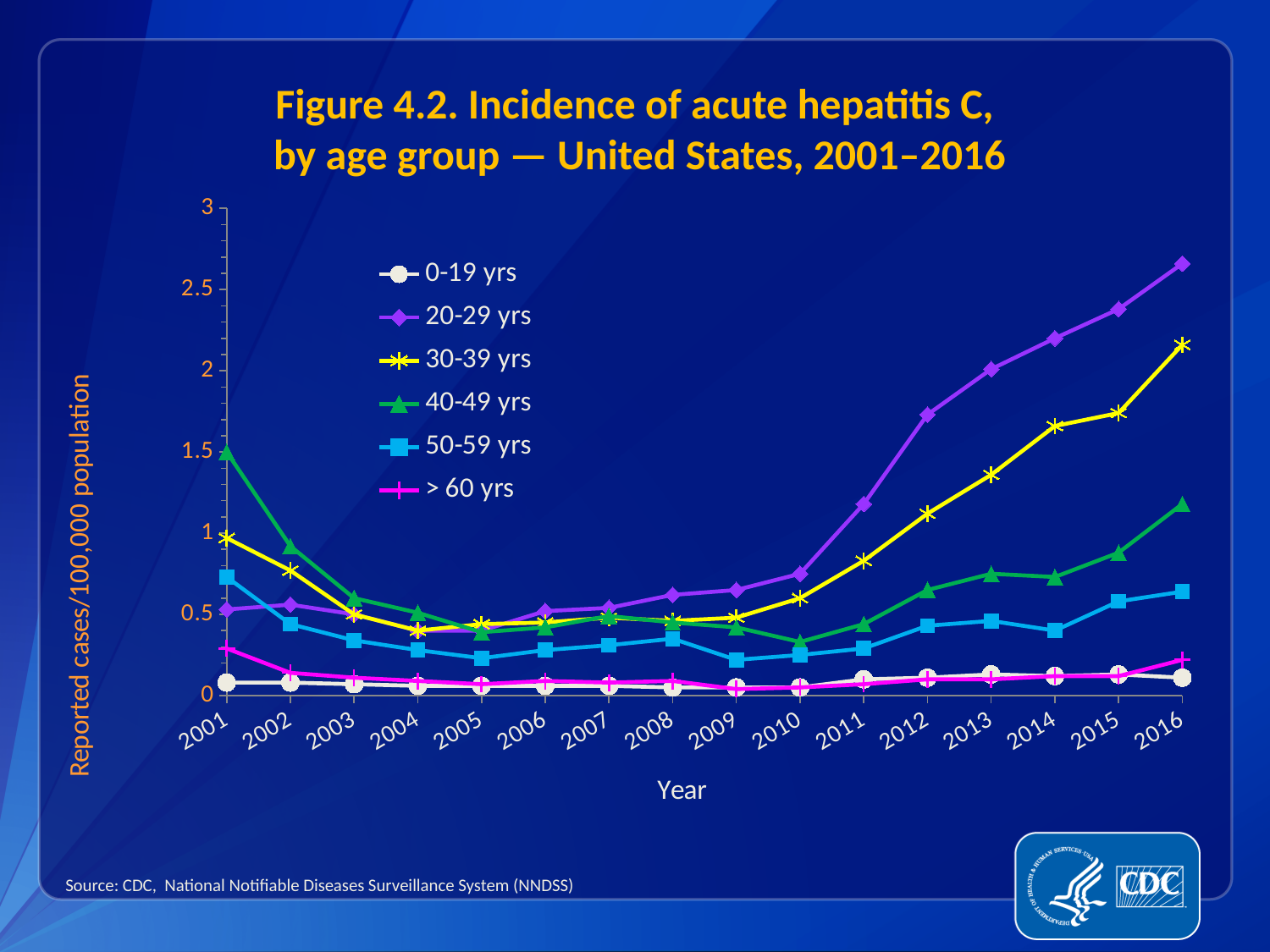
Which age group has the highest incidence in 2016? 20-29 yrs How many years are shown along the x axis? 16 Does the incidence for 20-29 yrs rise or fall from 2010 to 2016? rise Which age group has the lowest incidence in 2016? 0-19 yrs Is the value for 40-49 yrs in 2001 greater or less than 1? greater How many age-group series does the legend list? 6 Is the value for 20-29 yrs in 2016 greater or less than 2.5? greater Is the value for 30-39 yrs in 2016 greater or less than 2? greater Which age group has the highest incidence in 2001? 40-49 yrs In 2016, which is larger: the value for 40-49 yrs or the value for 50-59 yrs? 40-49 yrs What kind of chart is shown on the slide? line chart